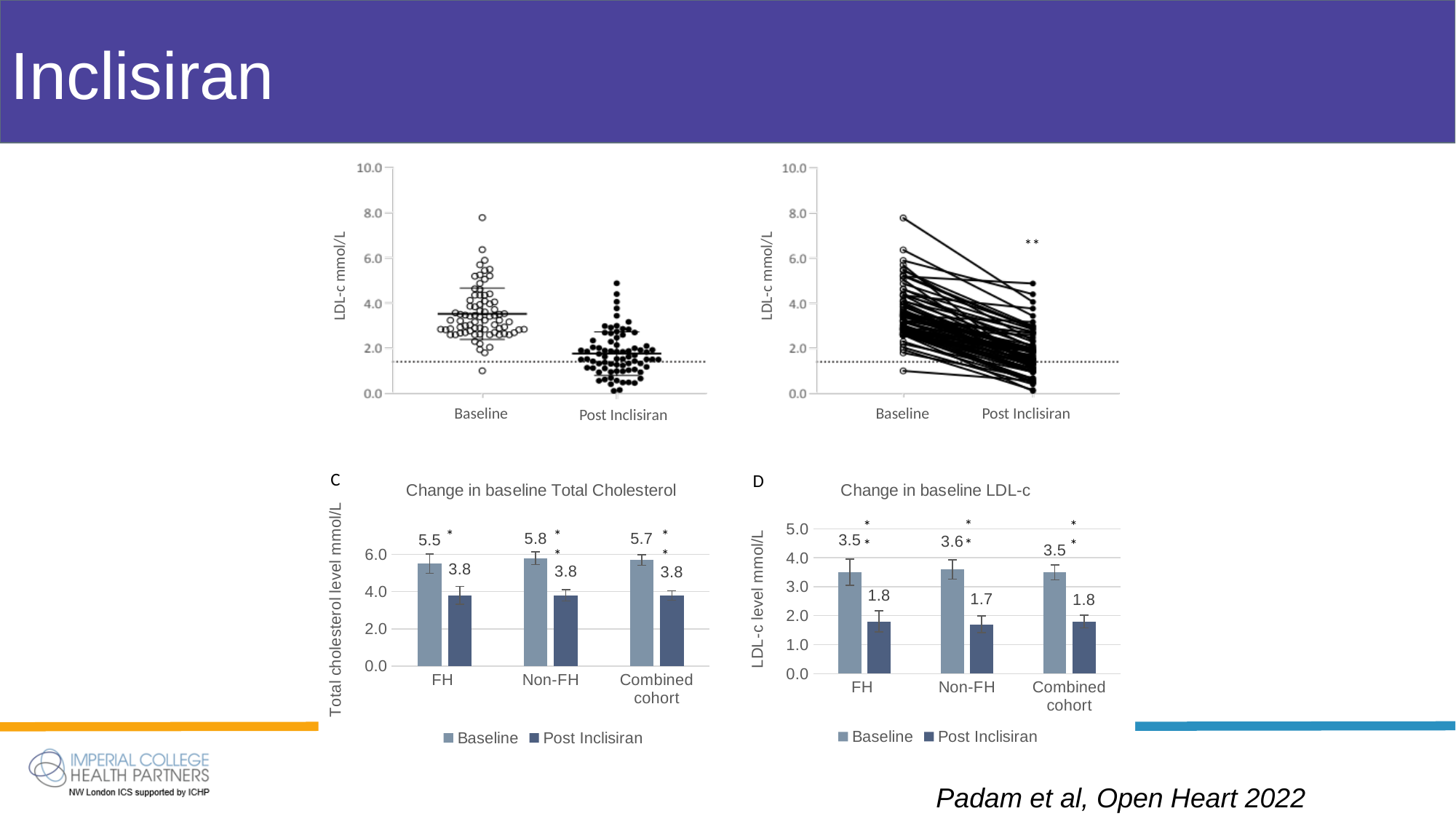
In the chart titled 'Change in baseline LDL-c', which is larger: the Baseline value for FH or the Baseline value for Non-FH? Non-FH In the top-left chart, how many categories are shown on the x axis? 2 In the chart titled 'Change in baseline Total Cholesterol', what is the Baseline value for Non-FH? 5.8 In the chart titled 'Change in baseline LDL-c', which category has the lowest Post Inclisiran value? Non-FH In the chart titled 'Change in baseline Total Cholesterol', what is the difference between the Baseline and Post Inclisiran values for FH? 1.7 In the chart titled 'Change in baseline Total Cholesterol', how many categories are shown on the x axis? 3 In the chart titled 'Change in baseline LDL-c', what is the Post Inclisiran value for Non-FH? 1.7 In the chart titled 'Change in baseline LDL-c', how many series does the legend list? 2 In the chart titled 'Change in baseline Total Cholesterol', which category has the highest Baseline value? Non-FH What is the title of the bottom-right chart on the slide? Change in baseline LDL-c What kind of chart is the chart titled 'Change in baseline Total Cholesterol'? Bar chart In the chart titled 'Change in baseline LDL-c', what is the difference between the Baseline and Post Inclisiran values for the Combined cohort? 1.7